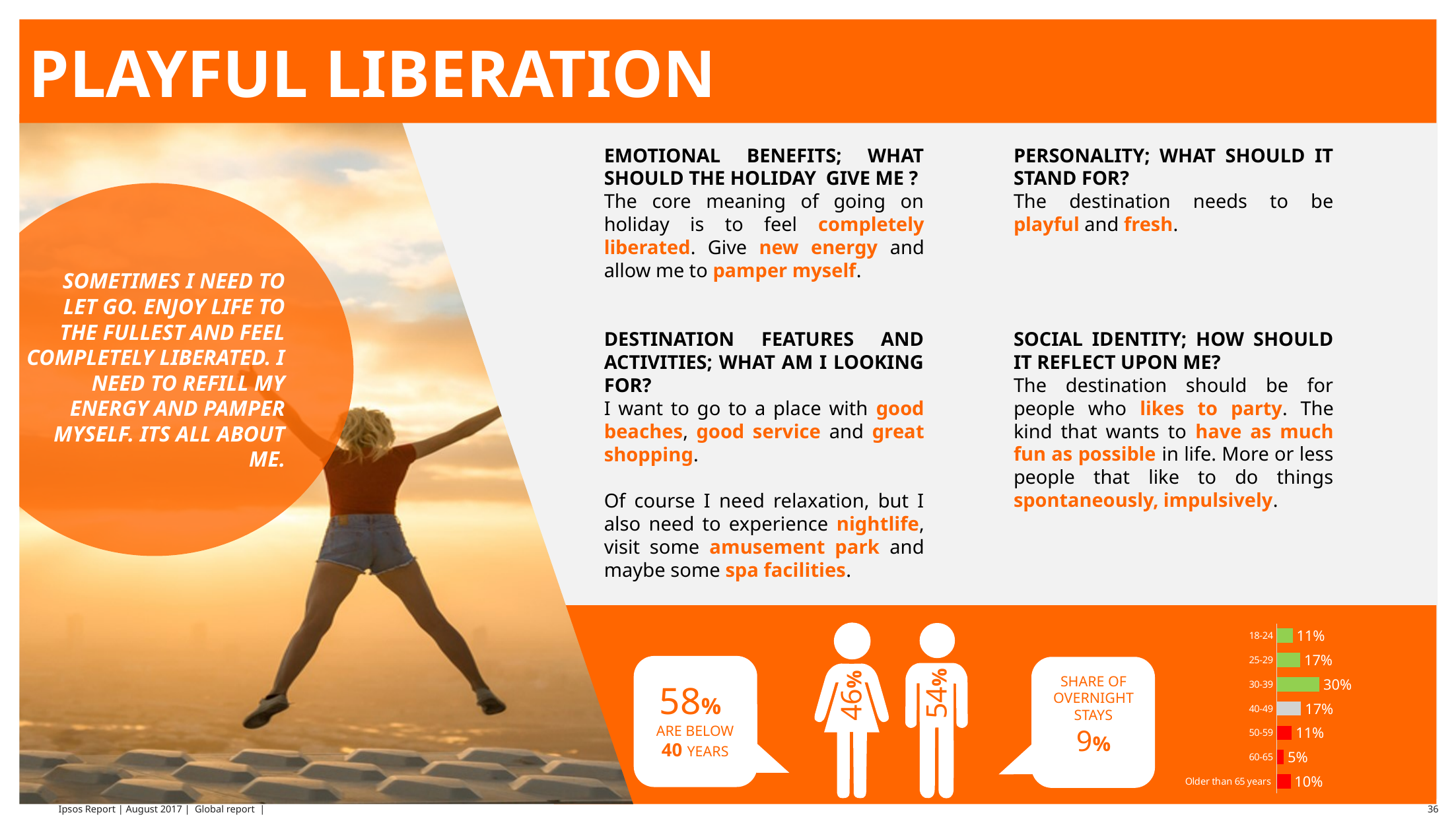
In the age-group bar chart, what is the value for the 60-65 age group? 5% How many age groups are shown in the age-group bar chart? 7 In the age-group bar chart, what is the value for 'Older than 65 years'? 10% What type of chart is used to show the age-group distribution? Bar chart According to the infographic, what is the share of overnight stays? 9% In the age-group bar chart, what is the difference between the 30-39 value and the 40-49 value? 13% In the age-group bar chart, which age group has the lowest value? 60-65 In the age-group bar chart, which age group has the highest value? 30-39 In the age-group bar chart, what is the value for the 30-39 age group? 30% In the age-group bar chart, which is larger: the value for 25-29 or the value for 18-24? 25-29 In the age-group bar chart, what is the combined value of the 18-24 and 25-29 age groups? 28% In the age-group bar chart, what colour are the bars for the 50-59, 60-65 and 'Older than 65 years' groups? Red